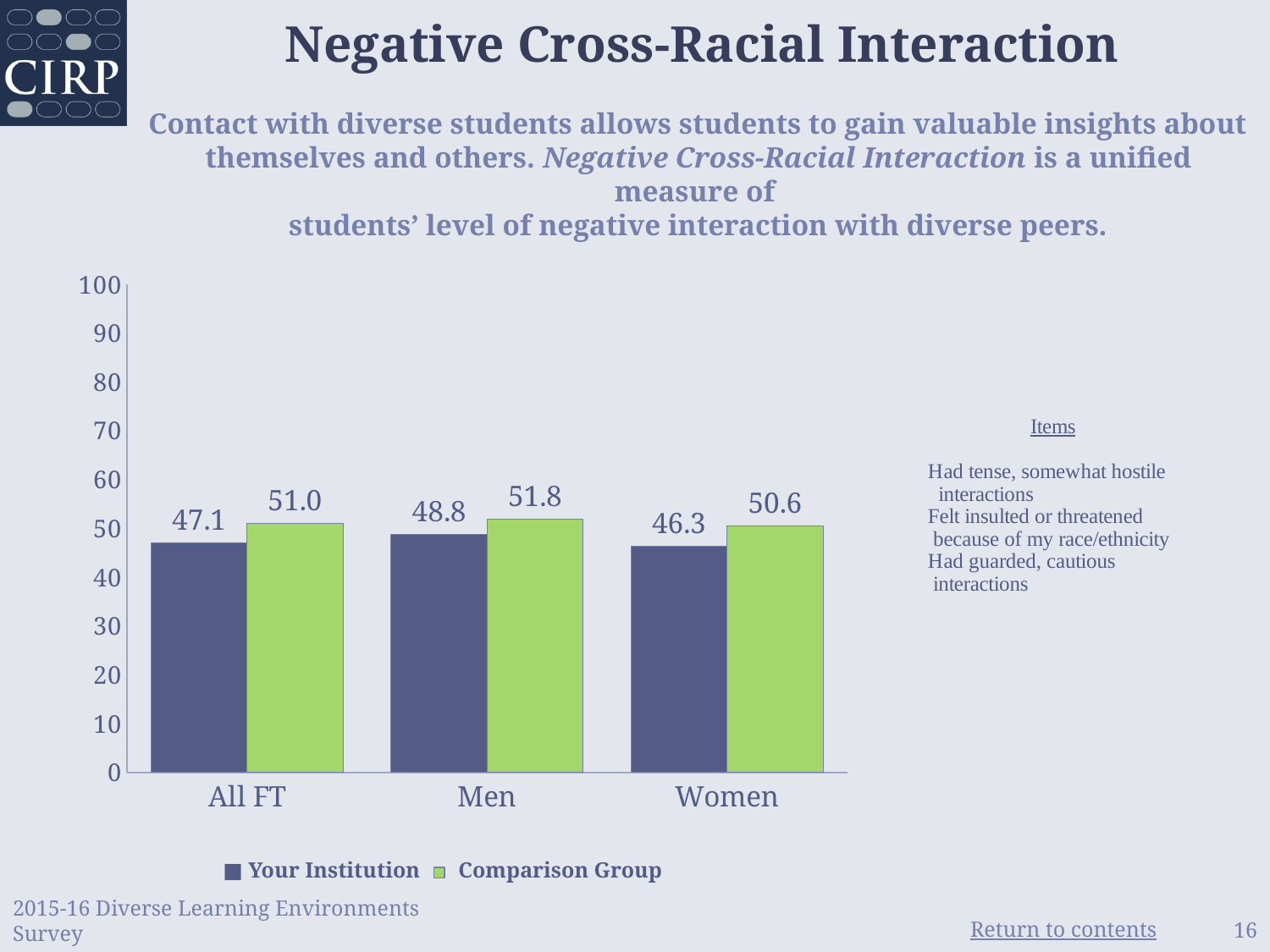
How many series does the legend list? 2 What kind of chart is shown on the slide? bar chart Which category has the lowest value for Comparison Group? Women What is the difference between the Comparison Group and Your Institution values for Men? 3.0 Which category has the highest value for Your Institution? Men Is the value for Your Institution in the Women category greater or less than 50? less Which is larger for All FT: Your Institution or Comparison Group? Comparison Group What is the value for Your Institution in the Women category? 46.3 What is the value for Comparison Group in the Men category? 51.8 What is the value for Your Institution in the All FT category? 47.1 How many categories are shown on the x axis? 3 What is the value for Comparison Group in the Women category? 50.6